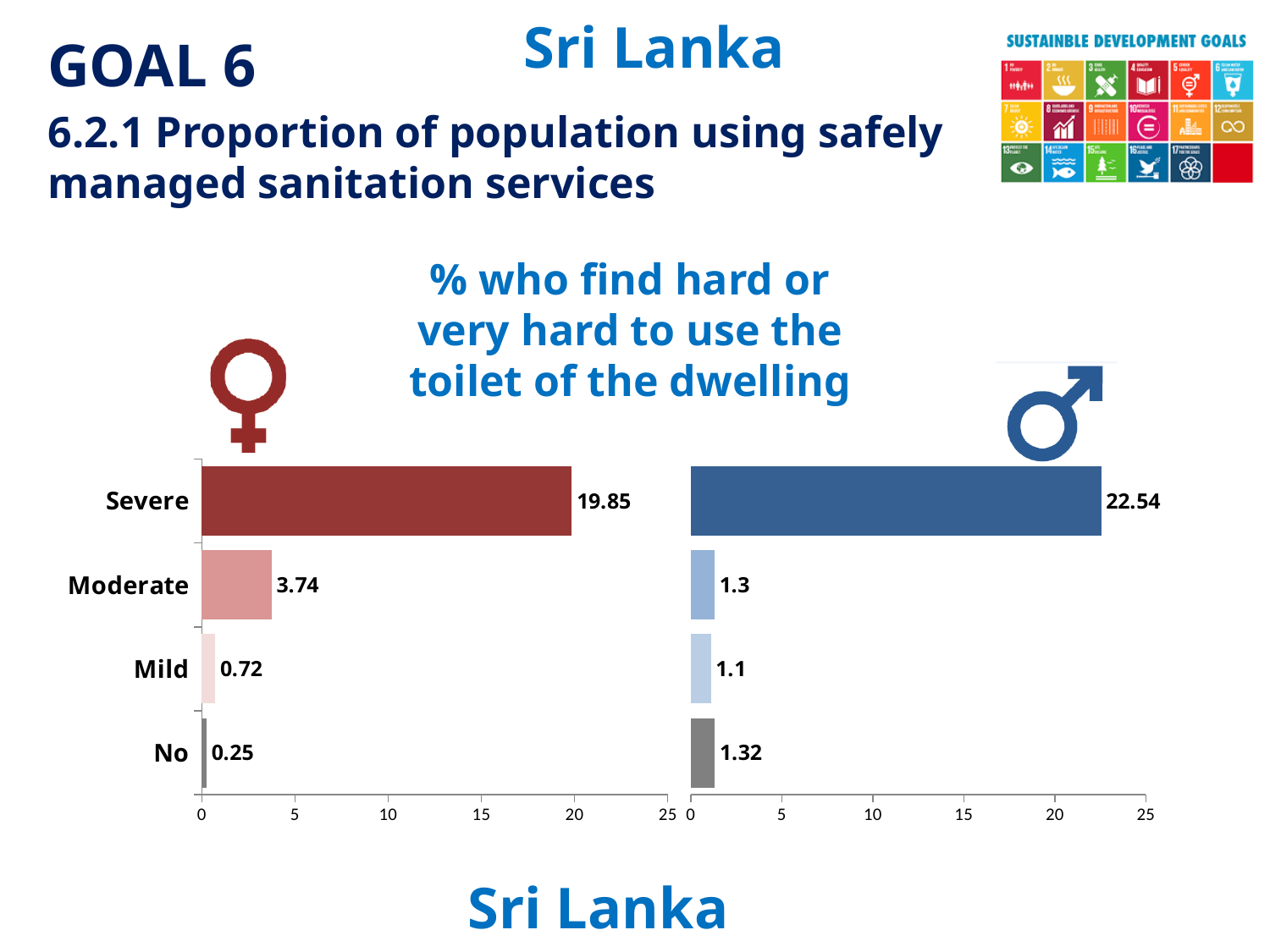
In the right (male) chart, what is the value for No? 1.32 In the right (male) chart, what is the value for Severe? 22.54 In the left (female) chart, what is the value for Moderate? 3.74 What kind of chart is the right (male) chart? Bar chart What is the difference between the Severe values in the right (male) chart and the left (female) chart? 2.69 What is the title shown above the two charts? % who find hard or very hard to use the toilet of the dwelling How many categories are shown in the left (female) chart? 4 In the left (female) chart, what is the value for Severe? 19.85 In the left (female) chart, is the value for Severe greater or less than 15? greater In the right (male) chart, which category has the highest value? Severe In the left (female) chart, which category has the lowest value? No Which is larger: the Moderate value in the left (female) chart or the Moderate value in the right (male) chart? Left (female) chart, 3.74